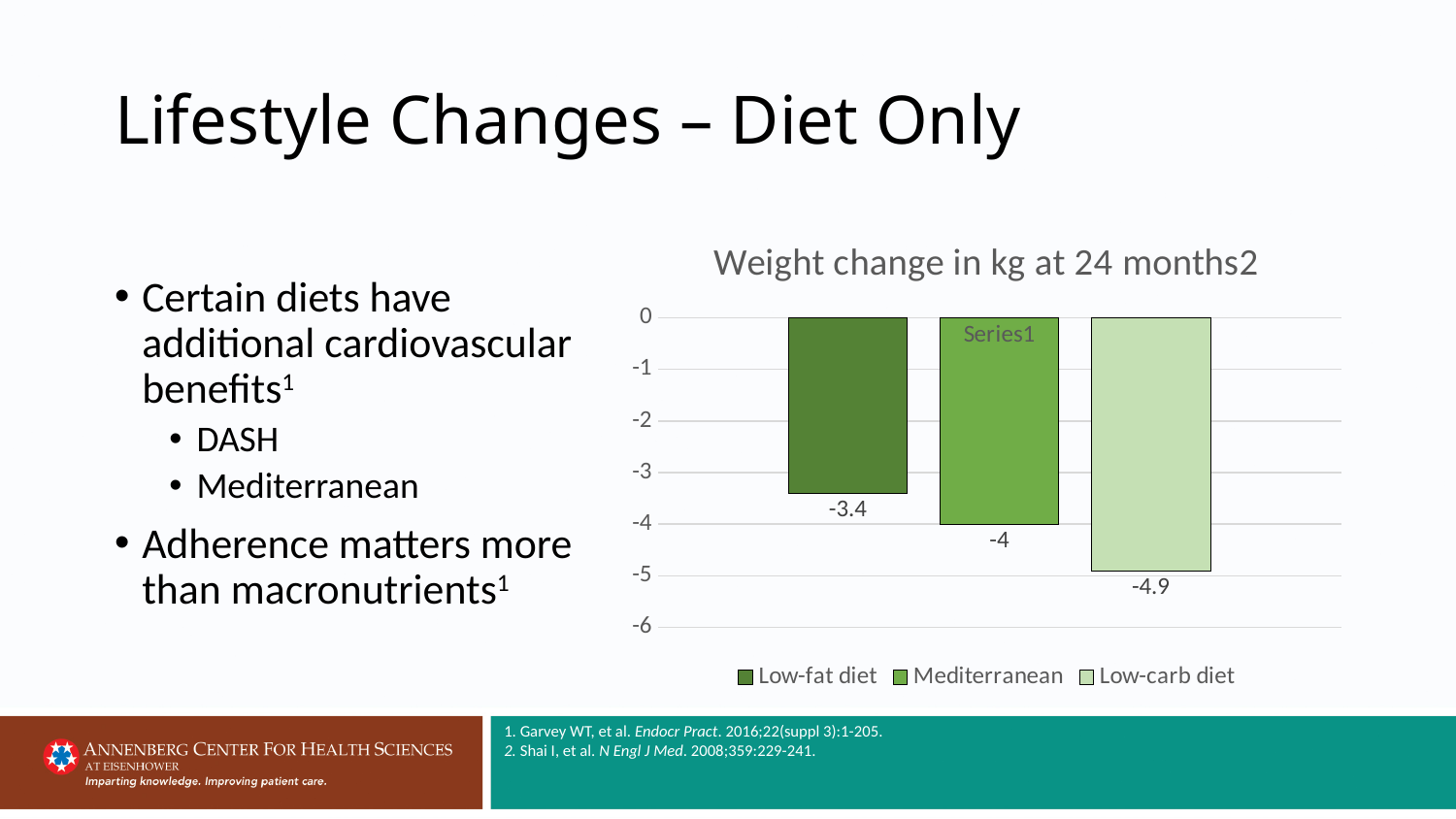
What is the weight change in kg at 24 months for the Low-fat diet? -3.4 How many bars are plotted in the chart? 3 What is the weight change in kg at 24 months for the Low-carb diet? -4.9 How many entries does the chart legend list? 3 By how many kg does the weight change for the Low-carb diet differ from that of the Low-fat diet? 1.5 Is the value for the Low-carb diet greater or less than -4? less What type of chart is shown on the slide? Bar chart Which diet shows the largest weight loss (most negative value) in the chart? Low-carb diet By how many kg does the weight change for the Mediterranean diet differ from that of the Low-fat diet? 0.6 Which diet has a greater weight loss, Mediterranean or Low-carb diet? Low-carb diet What is the weight change in kg at 24 months for the Mediterranean diet? -4 Which diet shows the smallest weight loss (least negative value) in the chart? Low-fat diet